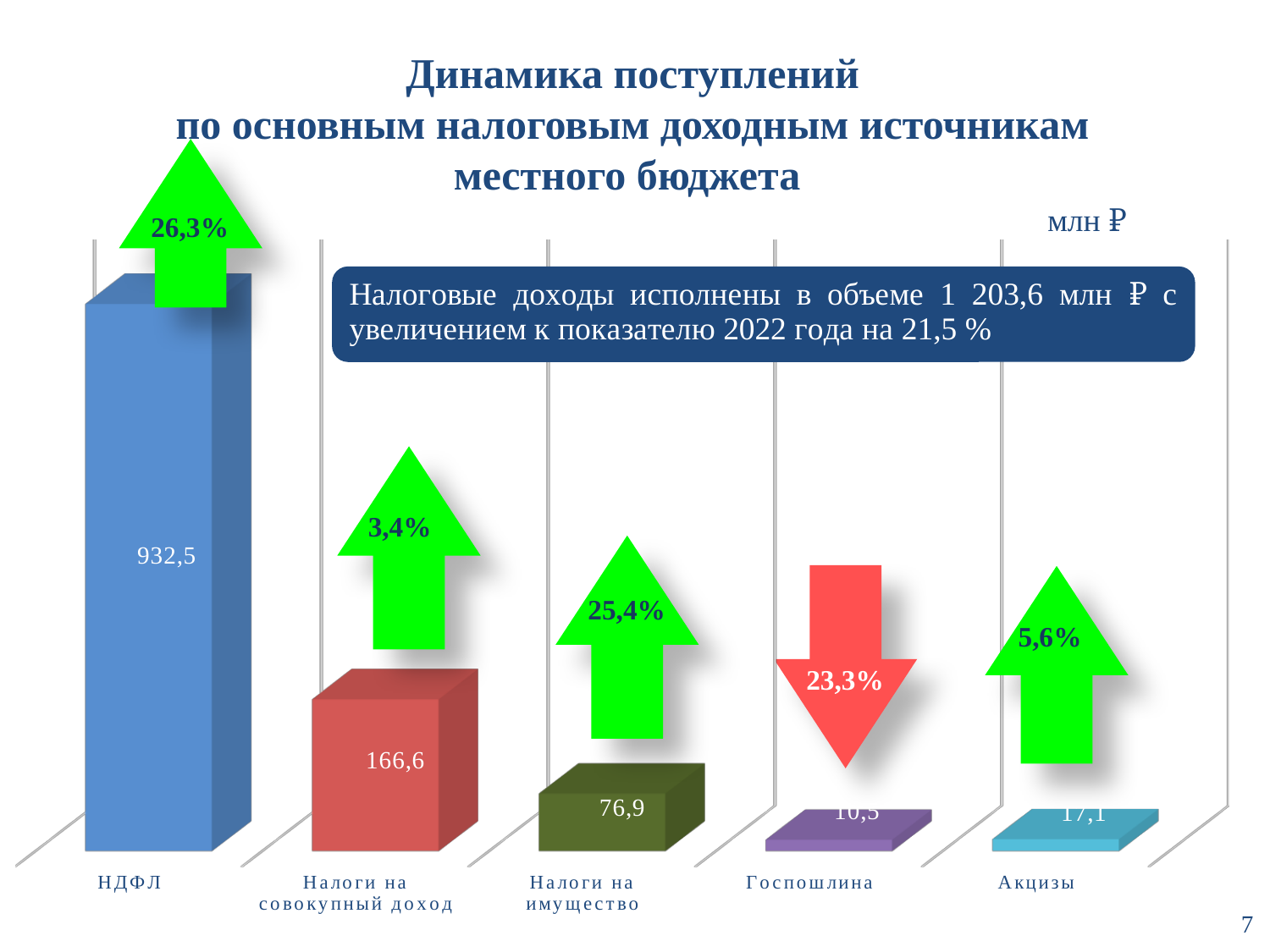
Which is larger, the value for НДФЛ or the value for Налоги на имущество? НДФЛ What is the value for Налоги на совокупный доход? 166,6 Which category has the highest value? НДФЛ What is the value for Налоги на имущество? 76,9 What kind of chart is shown on the slide? bar chart What percentage is shown on the arrow above the НДФЛ bar? 26,3% What is the difference between the values for Налоги на совокупный доход and Налоги на имущество? 89,7 What is the difference between the values for НДФЛ and Налоги на совокупный доход? 765,9 How many categories are shown in the chart? 5 Which category has a red downward arrow above its bar? Госпошлина Which category has the lowest value? Госпошлина What is the value for НДФЛ? 932,5